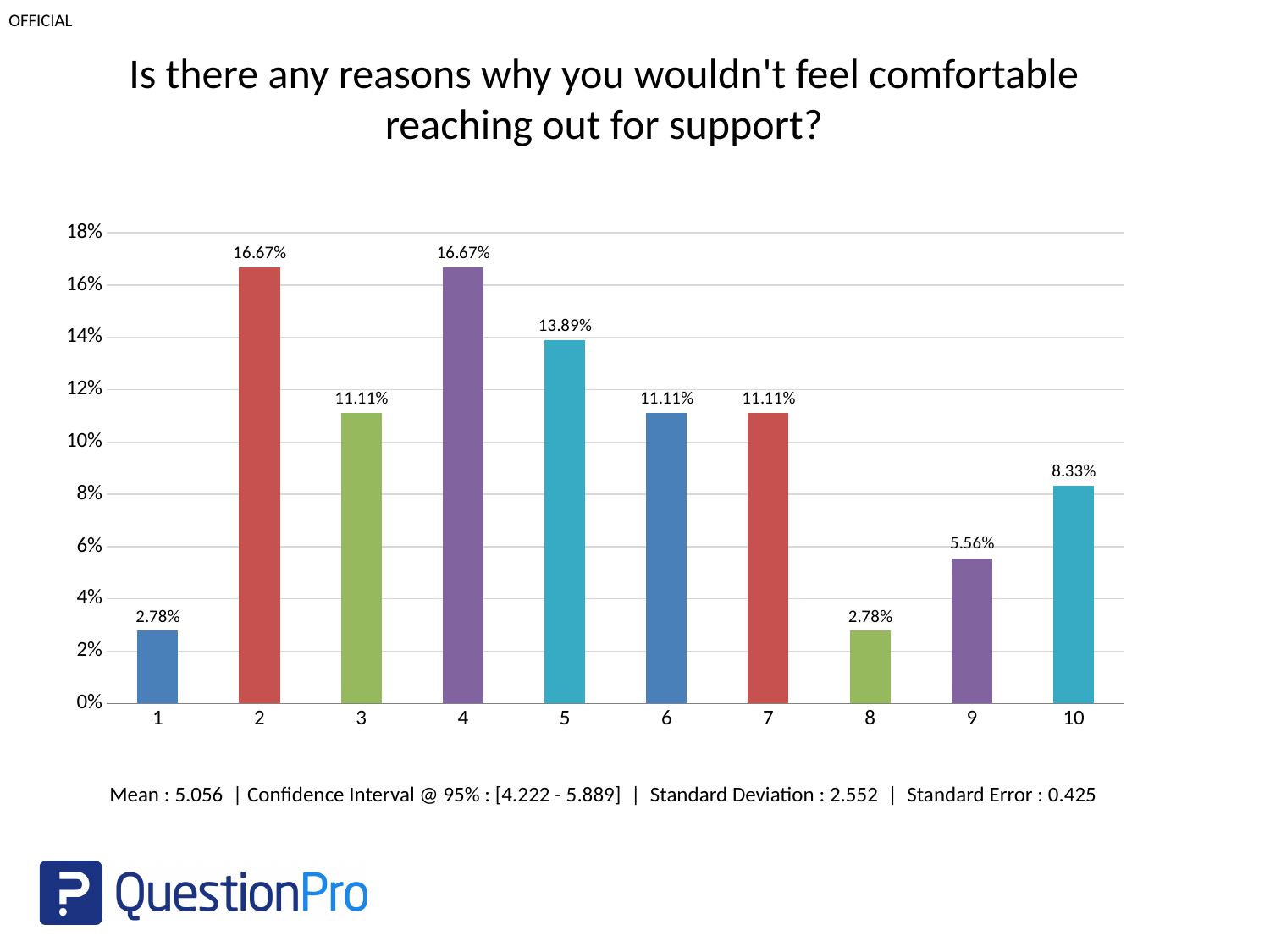
What is the lowest value shown in the chart? 2.78% What is the value for category 10? 8.33% Is the value for category 9 greater or less than 6%? less Which has a larger value, category 5 or category 6? 5 What is the value for category 9? 5.56% How many categories are shown on the x axis? 10 Which has a larger value, category 9 or category 10? 10 What is the difference between the values for category 2 and category 3? 5.56% What kind of chart is shown on the slide? bar chart What is the value for category 5? 13.89% What is the highest value shown in the chart? 16.67% What is the difference between the values for category 5 and category 10? 5.56%